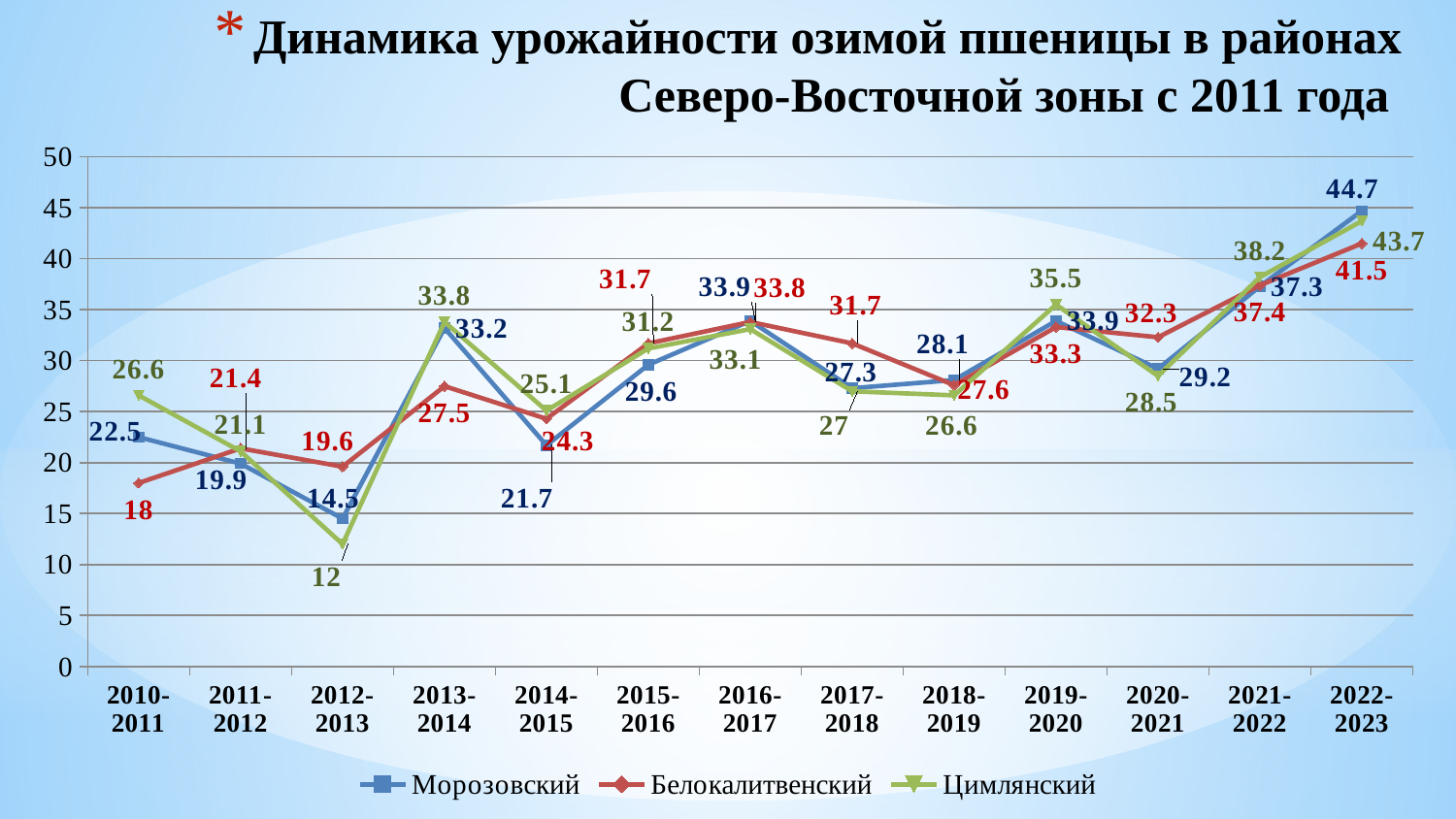
What kind of chart is shown on the slide? line chart In which season does the Морозовский series reach its highest value? 2022-2023 How many series does the legend list? 3 What is the value for Цимлянский in 2012-2013? 12 Which is larger in 2013-2014: the value for Морозовский or for Белокалитвенский? Морозовский How many seasons are shown on the x axis? 13 What is the value for Белокалитвенский in 2010-2011? 18 Which series is drawn in red? Белокалитвенский In which season does the Цимлянский series reach its lowest value? 2012-2013 What is the value for Цимлянский in 2019-2020? 35.5 What is the value for Морозовский in 2022-2023? 44.7 What is the difference between the Морозовский and Белокалитвенский values in 2022-2023? 3.2